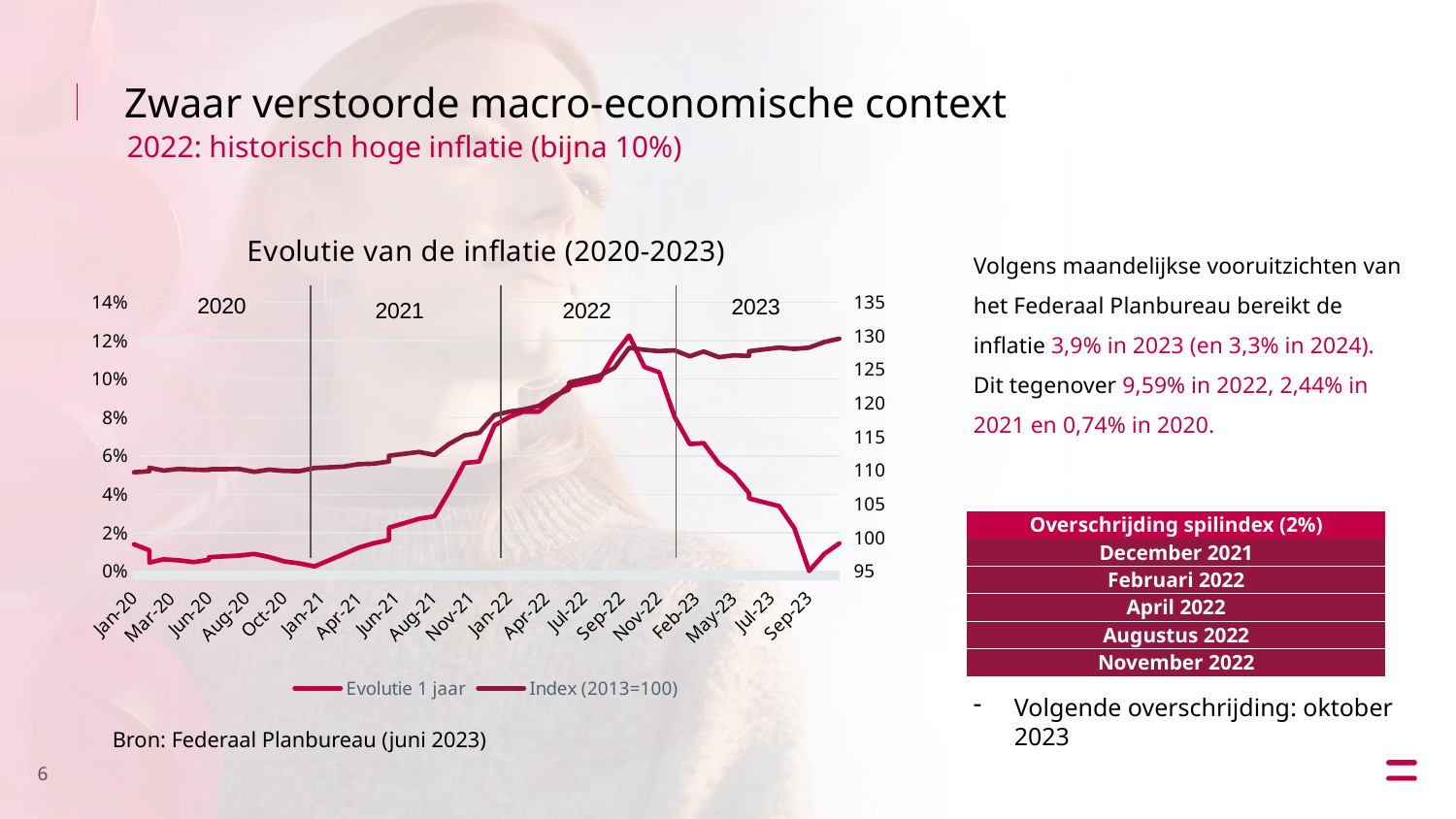
Is the 'Index (2013=100)' value at Jan-21 greater or less than 115? less How many series does the legend of the chart list? 2 Does the 'Evolutie 1 jaar' line rise or fall from Nov-22 to Jul-23? fall What are the two series named in the chart legend? Evolutie 1 jaar and Index (2013=100) Is the 'Evolutie 1 jaar' value at Jan-22 greater or less than 6%? greater Is the 'Index (2013=100)' value at Sep-23 greater or less than 125? greater What is the title of the chart on the slide? Evolutie van de inflatie (2020-2023) In which year does the 'Evolutie 1 jaar' line reach its highest point? 2022 Does the 'Index (2013=100)' line rise or fall overall from Jan-20 to Sep-23? rise What kind of chart is 'Evolutie van de inflatie (2020-2023)'? line chart